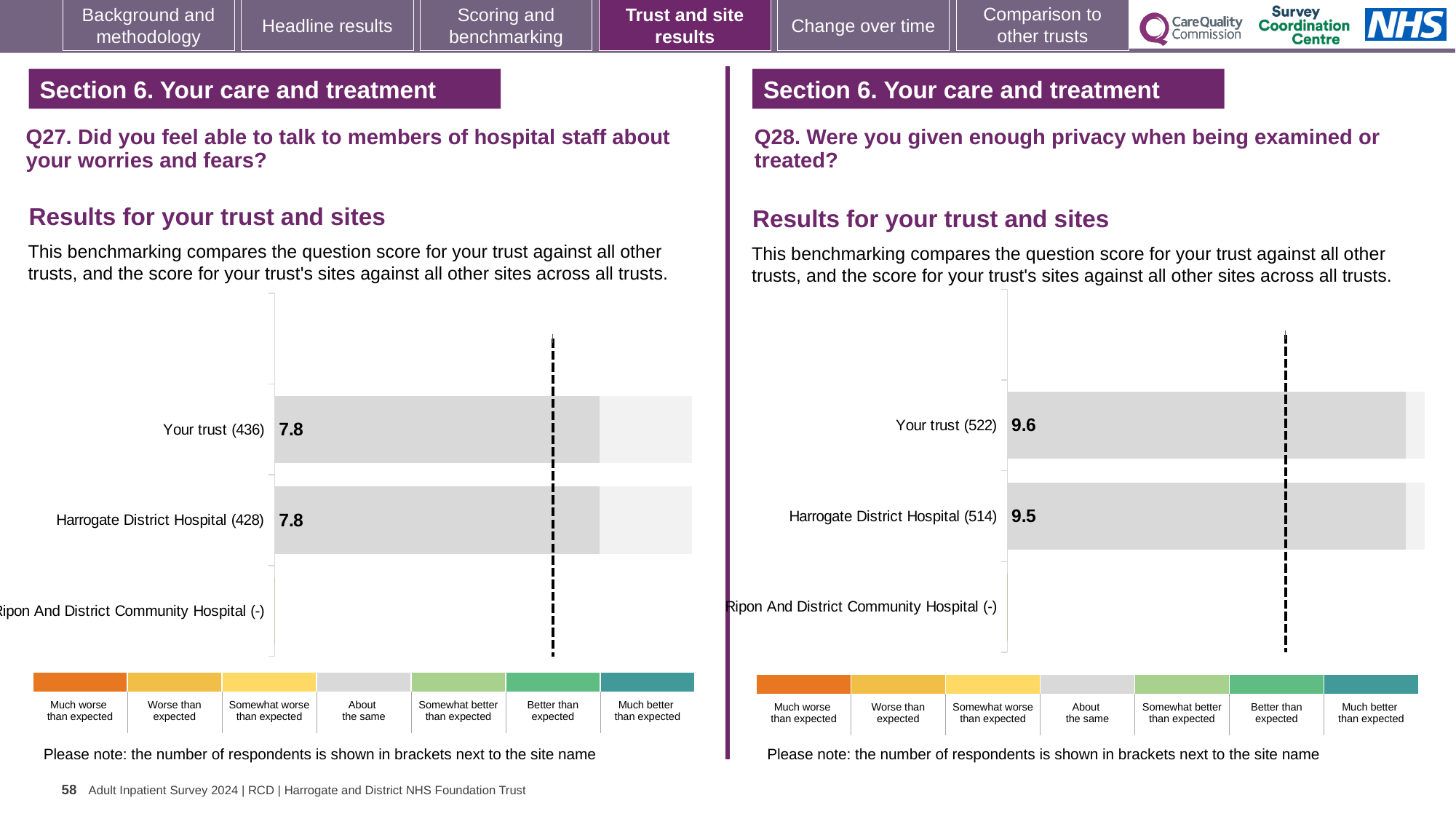
In the Q27 chart on the left, how many respondents are shown in brackets for Your trust? 436 What kind of chart is used for the Q28 results on the right? Bar chart In the Q28 chart on the right, what is the score for Harrogate District Hospital? 9.5 In the Q27 chart on the left, which category has no score shown? Ripon And District Community Hospital (-) In the Q27 chart on the left, what is the score for Harrogate District Hospital? 7.8 In the Q28 chart on the right, what is the difference between the score for Your trust and the score for Harrogate District Hospital? 0.1 In the Q28 chart on the right, what is the score for Your trust? 9.6 In the Q27 chart on the left, what is the score for Your trust? 7.8 How many benchmark categories are shown in the colour key below the Q28 chart on the right? 7 How many site/trust categories are listed on the y axis of the Q27 chart on the left? 3 In the Q28 chart on the right, which has the higher score, Your trust or Harrogate District Hospital? Your trust In the Q28 chart on the right, how many respondents are shown in brackets for Harrogate District Hospital? 514